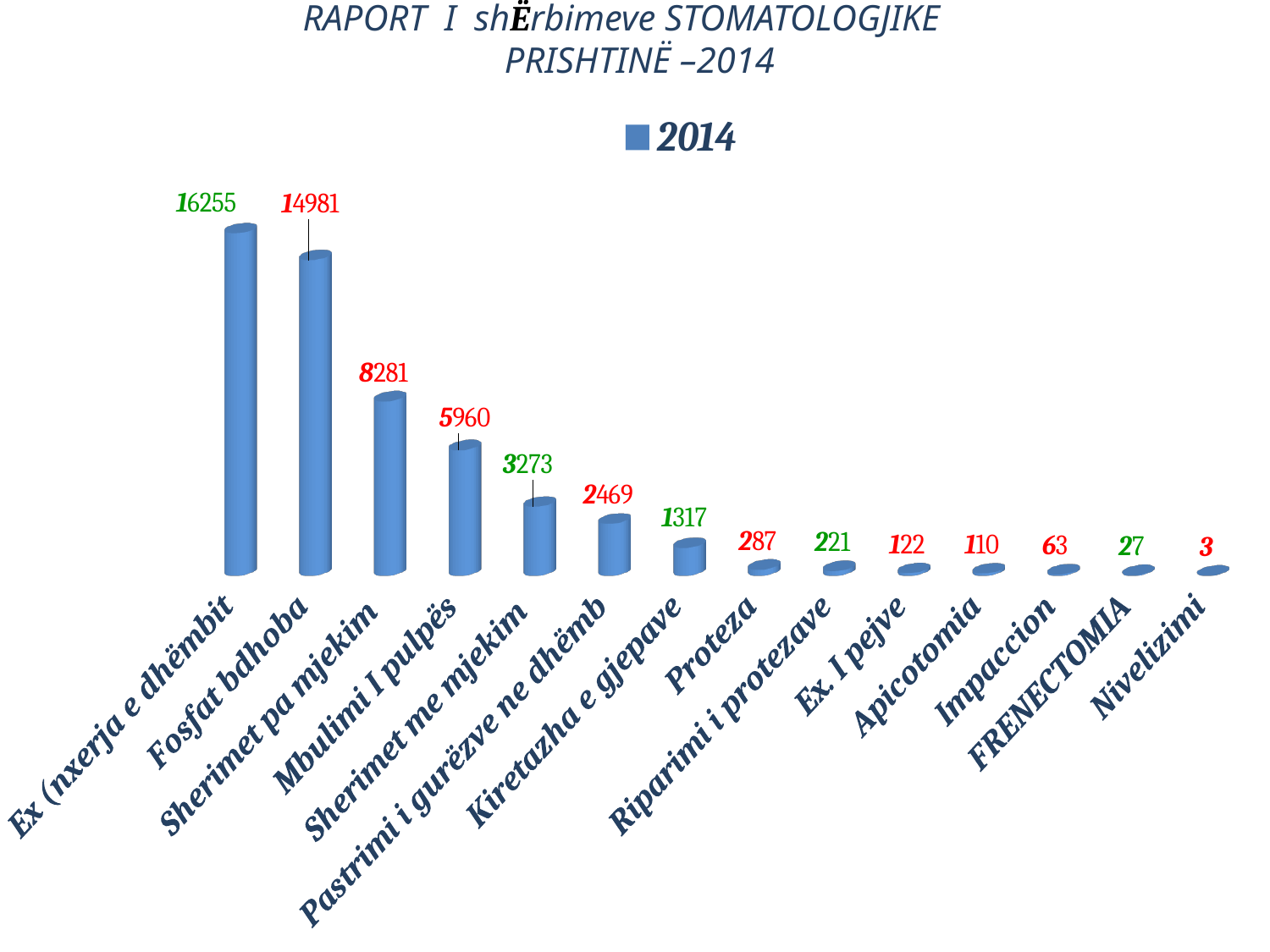
How many categories are shown on the x axis? 14 Which category has the highest value? Ex (nxerja e dhëmbit Which is larger, the value for Mbulimi I pulpës or the value for Sherimet me mjekim? Mbulimi I pulpës What is the value for Nivelizimi? 3 What is the value for Proteza? 287 What is the difference between the values for Ex (nxerja e dhëmbit and Fosfat bdhoba? 1274 What is the value for Sherimet pa mjekim? 8281 Do the values rise or fall from left to right along the x axis? Fall Which category has the lowest value? Nivelizimi What kind of chart is shown on the slide? Bar chart How many series does the legend list? 1 What is the value for Fosfat bdhoba? 14981